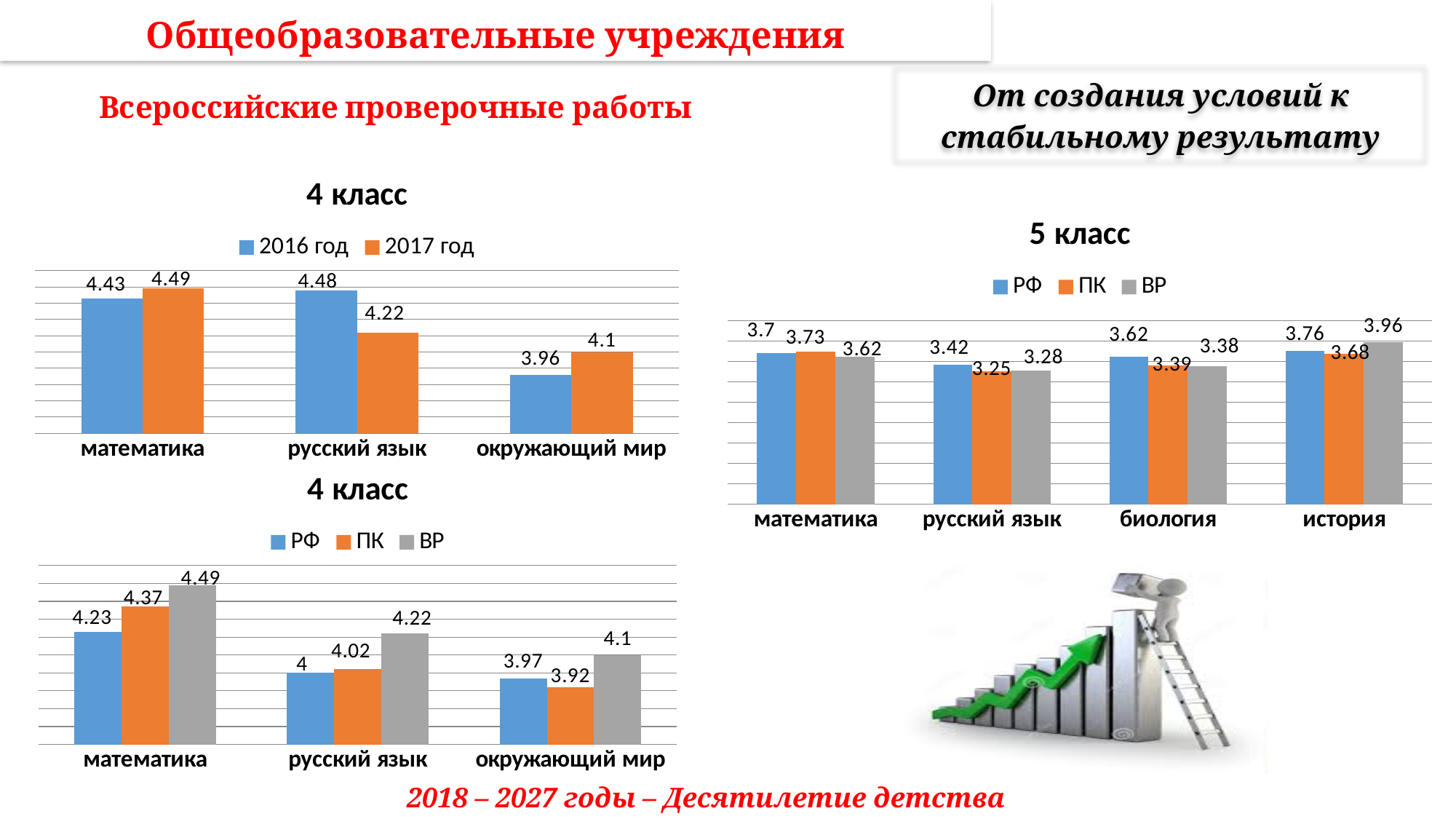
In the '5 класс' chart, how many subjects are shown on the x axis? 4 In the bottom-left '4 класс' chart, which is larger for окружающий мир: the РФ value or the ПК value? РФ In the bottom-left '4 класс' chart, what is the ВР value for математика? 4.49 In the bottom-left '4 класс' chart, what is the difference between the ВР and РФ values for русский язык? 0.22 In the top-left '4 класс' chart, what is the value for математика in 2017 год? 4.49 What type of chart is the '5 класс' chart? bar chart In the '5 класс' chart, which subject has the highest ВР value? история In the top-left '4 класс' chart, what is the difference between the 2016 год and 2017 год values for окружающий мир? 0.14 In the top-left '4 класс' chart, which subject has the lowest 2016 год value? окружающий мир In the '5 класс' chart, what is the ПК value for биология? 3.39 In the top-left '4 класс' chart, how many series does the legend list? 2 In the top-left '4 класс' chart, what is the value for русский язык in 2016 год? 4.48